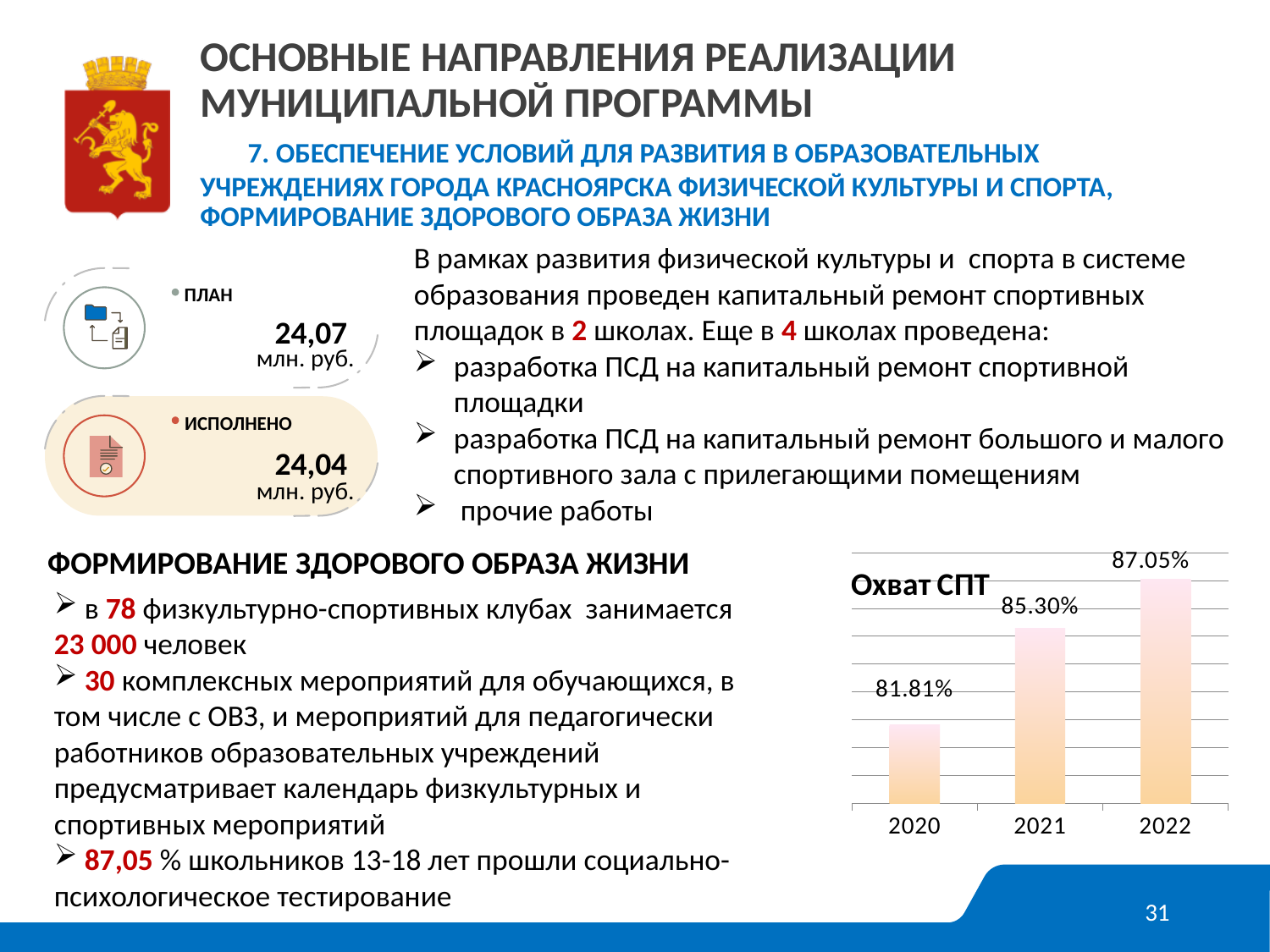
What is the difference between the 2022 and 2020 values in the Охват СПТ chart? 5.24% Which year has the highest value in the Охват СПТ chart? 2022 What is the title of the chart on the slide? Охват СПТ What is the difference between the 2021 and 2020 values in the Охват СПТ chart? 3.49% What is the value for 2020 in the Охват СПТ chart? 81.81% What is the value for 2021 in the Охват СПТ chart? 85.30% What is the value for 2022 in the Охват СПТ chart? 87.05% Which year has the lowest value in the Охват СПТ chart? 2020 What kind of chart is the Охват СПТ chart? bar chart Do the values in the Охват СПТ chart rise or fall from 2020 to 2022? rise How many years are shown in the Охват СПТ chart? 3 Is the value for 2021 or 2022 larger in the Охват СПТ chart? 2022